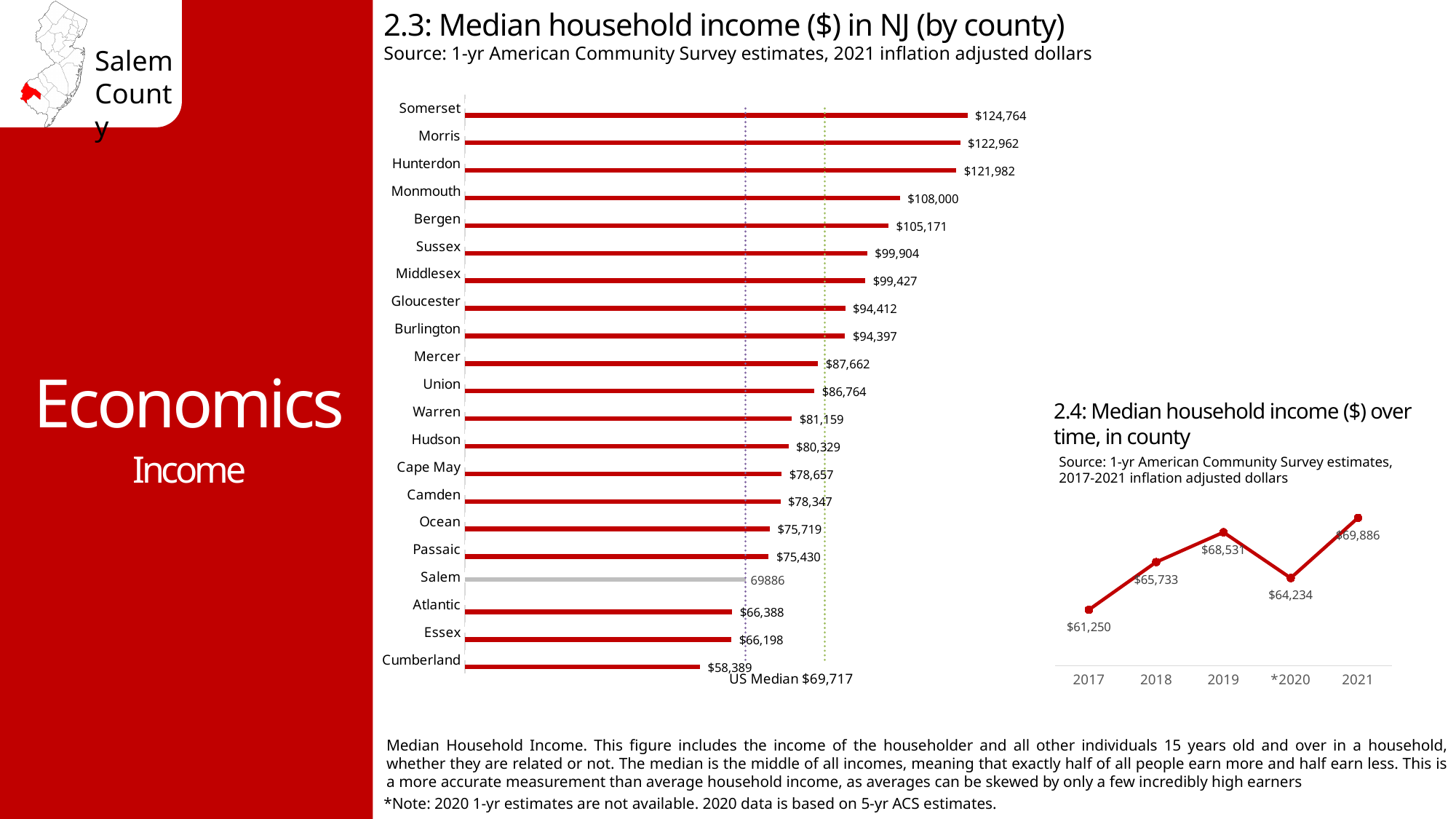
In chart 2.3 (Median household income in NJ by county), what is the median household income for Cumberland? $58,389 In chart 2.3 (Median household income in NJ by county), what is the median household income for Somerset? $124,764 In chart 2.3 (Median household income in NJ by county), which county has a higher median household income, Monmouth or Mercer? Monmouth In chart 2.3 (Median household income in NJ by county), what US Median value is marked on the chart? $69,717 In chart 2.3 (Median household income in NJ by county), which county has the lowest median household income? Cumberland In chart 2.4 (Median household income over time, in county), what is the value for 2019? $68,531 In chart 2.3 (Median household income in NJ by county), how many counties are shown? 21 In chart 2.4 (Median household income over time, in county), what is the difference between the 2021 and 2017 values? $8,636 In chart 2.3 (Median household income in NJ by county), what is the difference between Somerset's and Cumberland's median household income? $66,375 In chart 2.4 (Median household income over time, in county), which year has the lowest value? 2017 In chart 2.3 (Median household income in NJ by county), which county has the highest median household income? Somerset What kind of chart is chart 2.3 (Median household income in NJ by county)? Bar chart